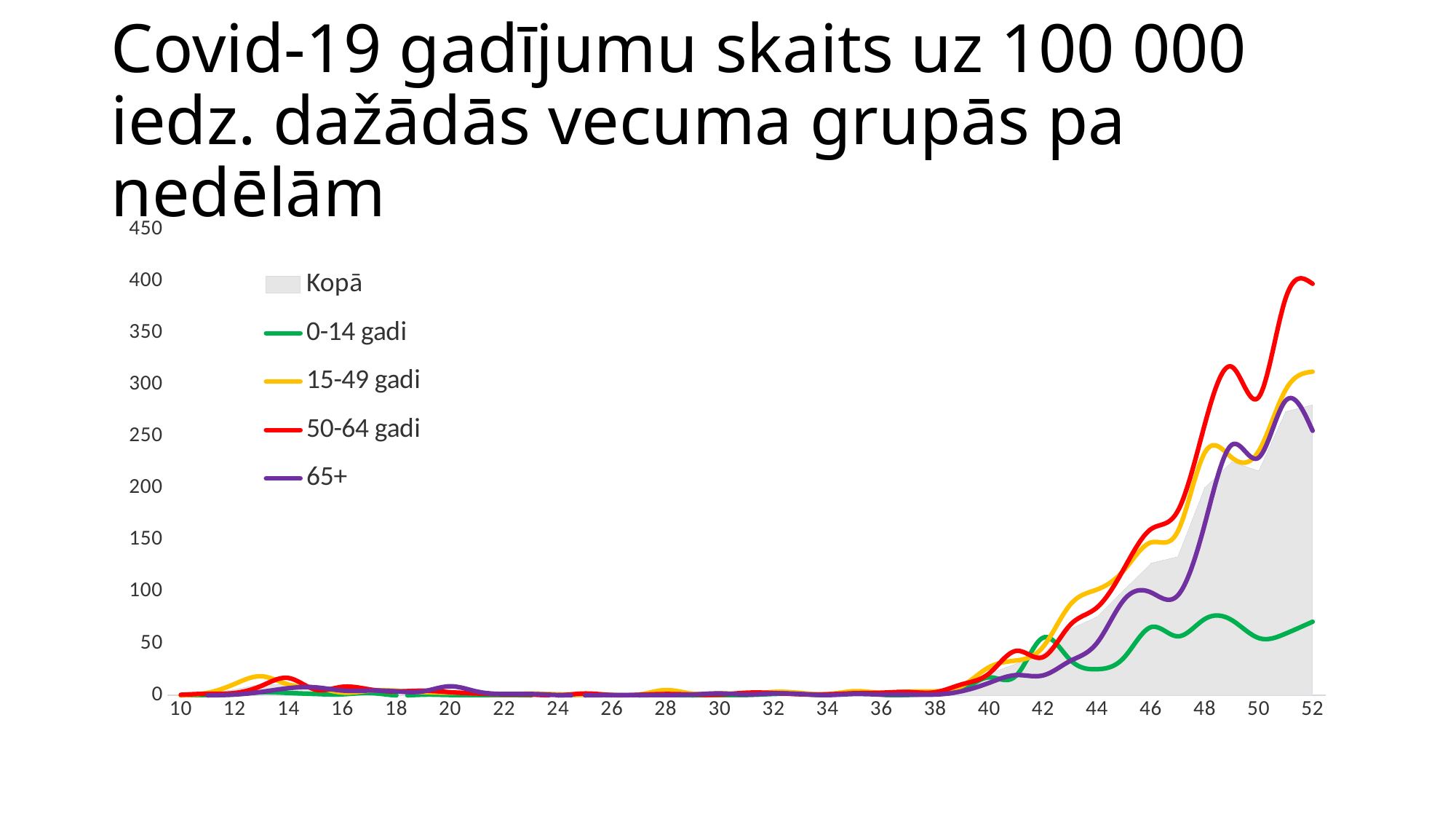
Which series has the highest value at week 52? 50-64 gadi What kind of chart is shown on the slide? combination area and line chart (lines with a shaded area) Is the value for 50-64 gadi at week 52 greater or less than 350? greater How many series does the legend list? 5 Is the value for 0-14 gadi at week 52 greater or less than 100? less At week 48, which is larger: the value for 15-49 gadi or the value for 65+? 15-49 gadi At week 52, which is larger: the value for 50-64 gadi or the value for 0-14 gadi? 50-64 gadi Which series is drawn as a shaded grey area rather than a line? Kopā Which series has the lowest value at week 52? 0-14 gadi Do the values for 50-64 gadi rise or fall between week 38 and week 52? rise Is the value for 15-49 gadi at week 52 greater or less than 250? greater